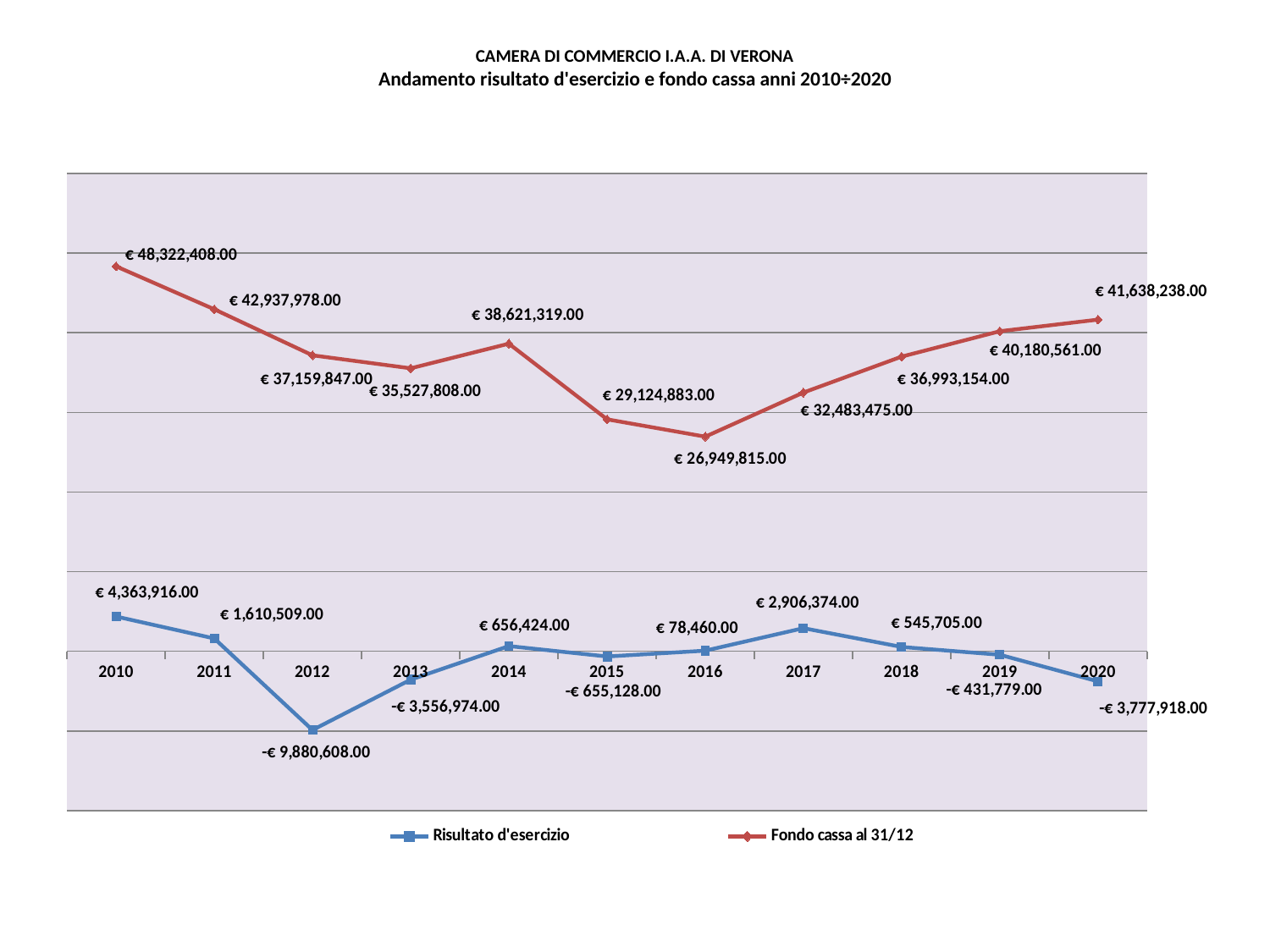
In which year is Fondo cassa al 31/12 lowest? 2016 In which year is Risultato d'esercizio lowest? 2012 How many series does the legend list? 2 Does Fondo cassa al 31/12 rise or fall from 2016 to 2020? rise What is the Risultato d'esercizio for 2012? -€ 9,880,608.00 What is the value of Fondo cassa al 31/12 in 2020? € 41,638,238.00 In which year is Risultato d'esercizio highest? 2010 Which is larger, the Risultato d'esercizio in 2017 or in 2018? 2017 How many years are shown on the x axis? 11 What is the difference between Fondo cassa al 31/12 in 2020 and in 2019? € 1,457,677.00 What is the value of Fondo cassa al 31/12 in 2010? € 48,322,408.00 By how much did Fondo cassa al 31/12 decrease from 2010 to 2020? € 6,684,170.00